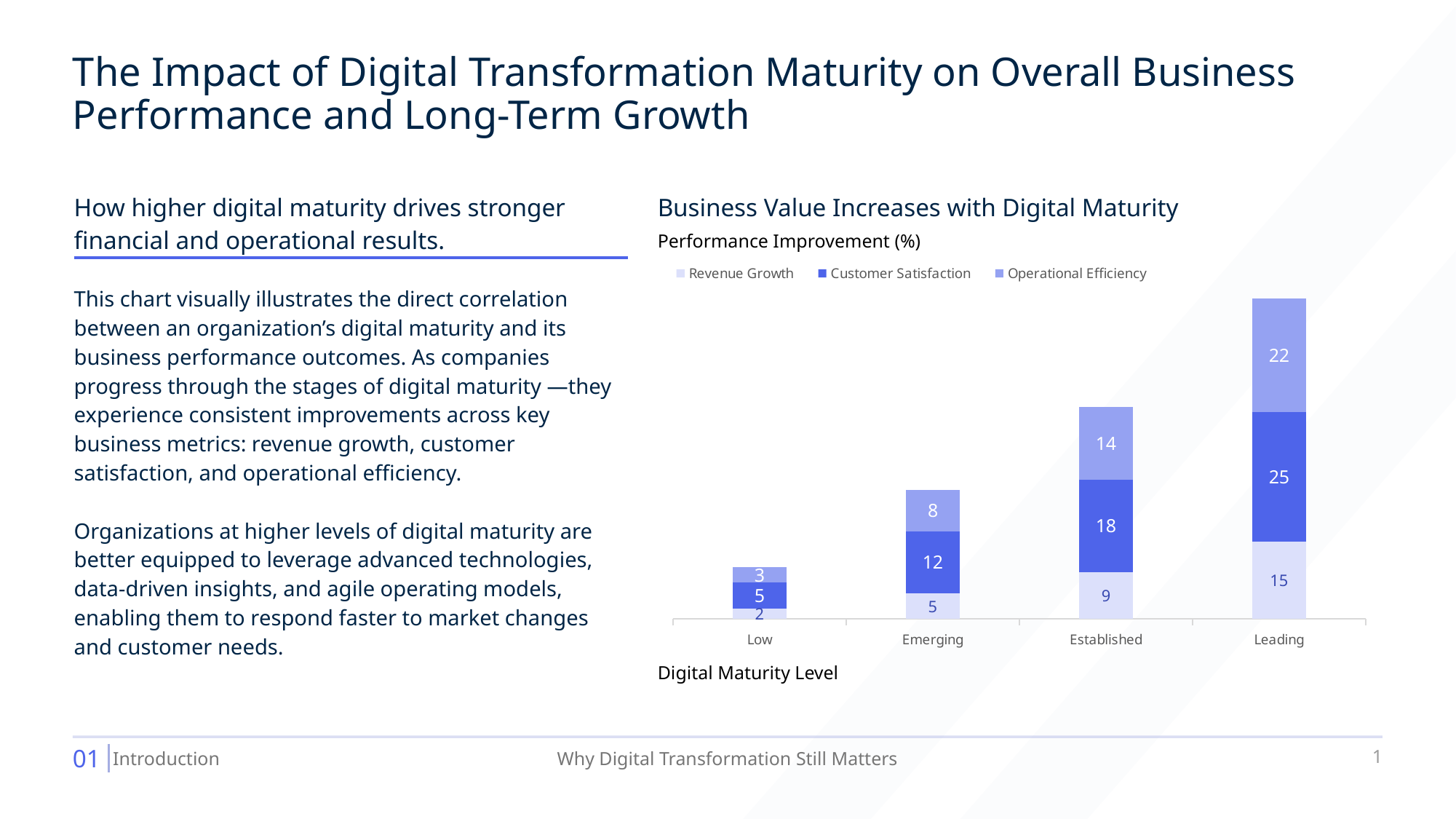
Do the Customer Satisfaction values rise or fall from Low to Leading? Rise Which maturity level has the lowest Revenue Growth value? Low How many series does the legend list? 3 What kind of chart is shown on the slide? Stacked bar chart What is the total of the stacked bar for the Leading maturity level? 62 Which is larger: Customer Satisfaction for Emerging or Revenue Growth for Established? Customer Satisfaction for Emerging What is the difference between the Operational Efficiency values for Leading and Established? 8 What is the Operational Efficiency value for the Emerging maturity level? 8 What is the Customer Satisfaction value for the Established maturity level? 18 Which maturity level has the highest Customer Satisfaction value? Leading What is the Revenue Growth value for the Leading maturity level? 15 How many digital maturity levels are shown on the x axis? 4